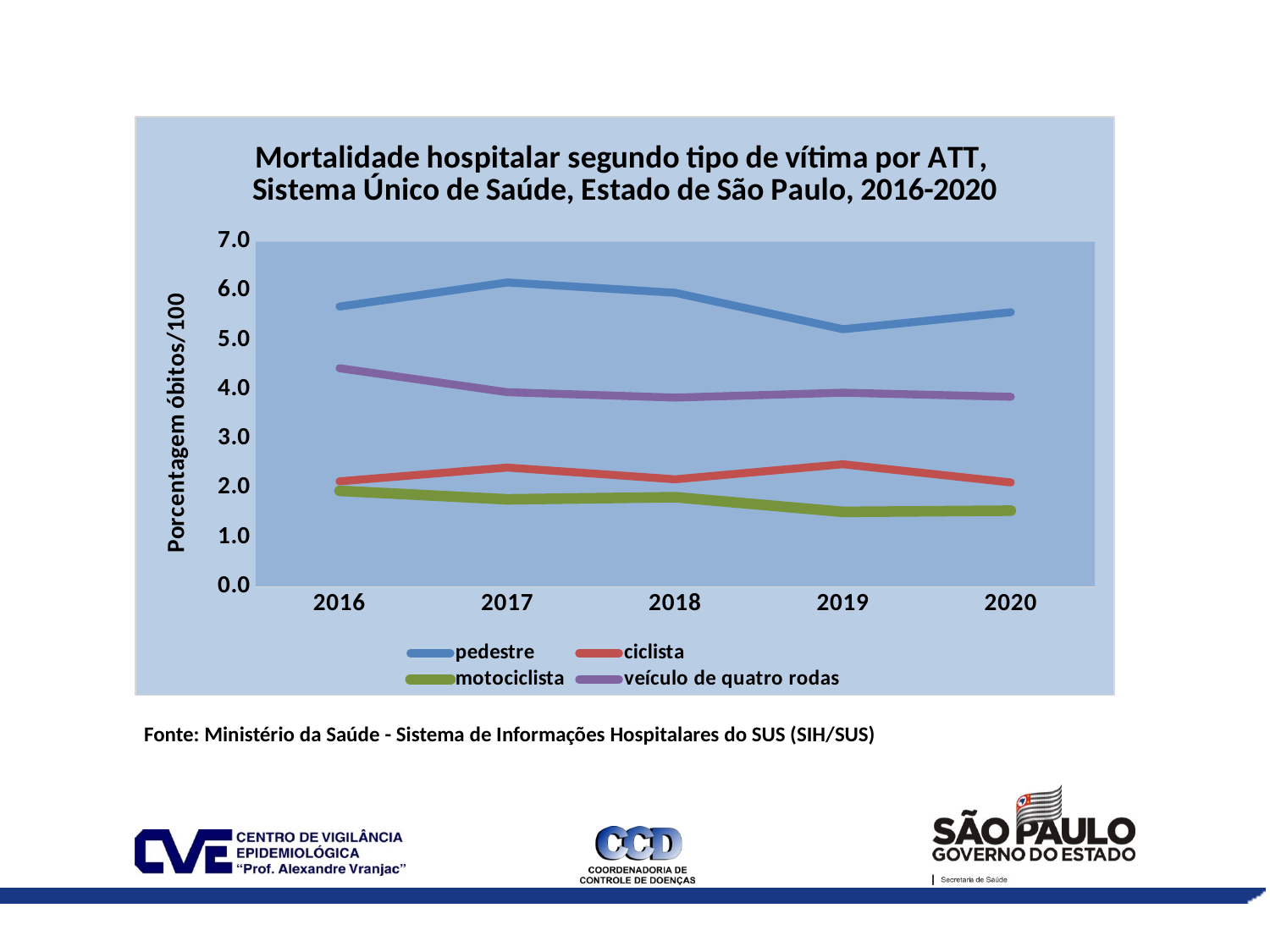
Is the value for motociclista in 2019 greater or less than 2.0? less How many series does the legend list? 4 Is the value for veículo de quatro rodas in 2016 greater or less than 4.0? greater In which year is the value for pedestre lowest? 2019 Which victim type has the lowest value in 2020? motociclista How many years are plotted along the x axis? 5 In which year is the value for veículo de quatro rodas highest? 2016 In which year is the value for pedestre highest? 2017 What kind of chart is shown on the slide? line chart Does the value for motociclista rise or fall from 2016 to 2020? fall Is the value for pedestre in 2019 greater or less than 6.0? less Which victim type has the highest hospital mortality in every year shown? pedestre